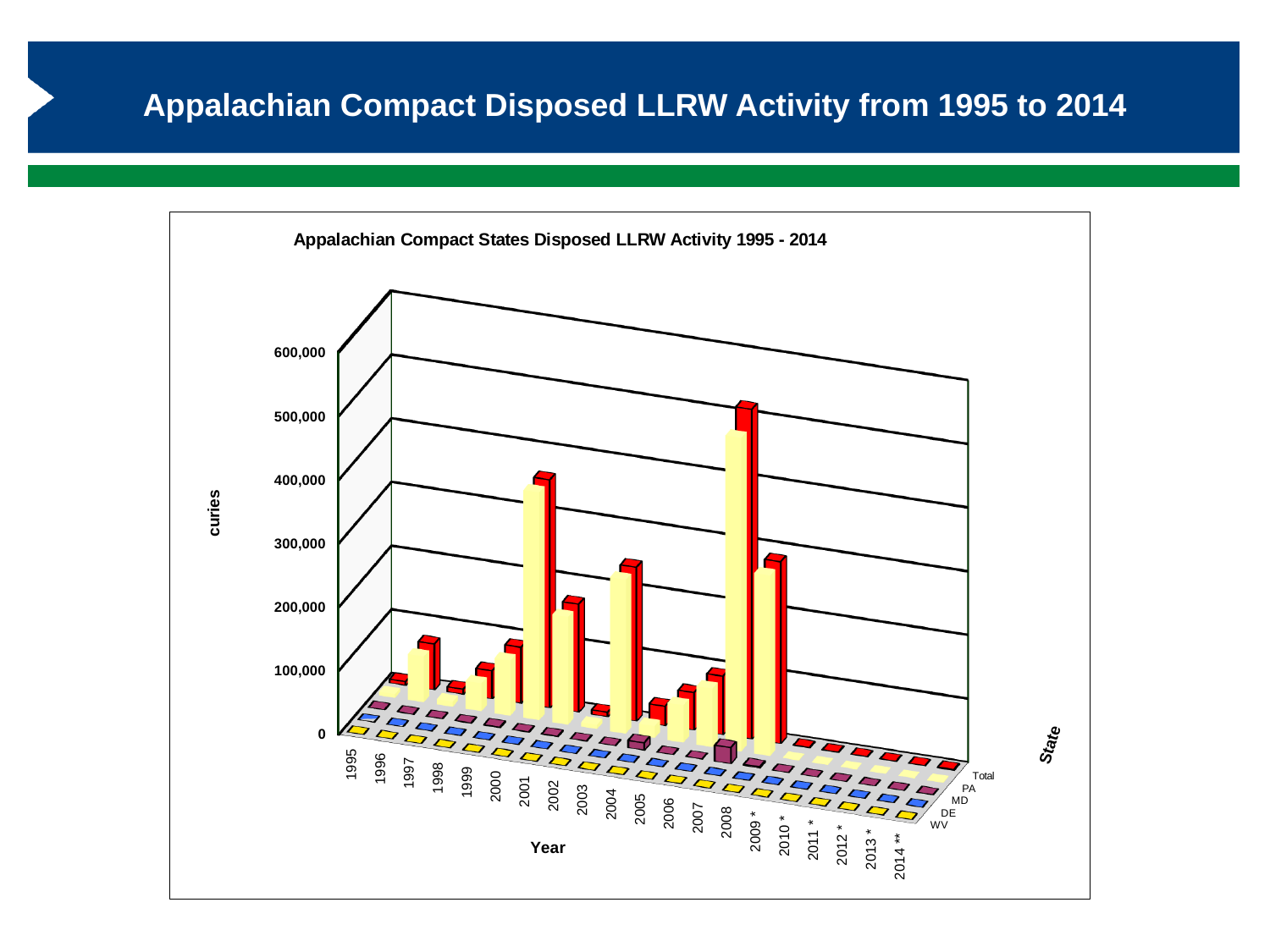
How many years are shown along the Year axis of the chart? 20 How many state series are shown on the State axis of the chart? 5 Which year has the highest Total disposed LLRW activity? 2007 Is the Total value for 1995 greater or less than 100,000 curies? less What is the title of the chart? Appalachian Compact States Disposed LLRW Activity 1995 - 2014 Is the Total value for 2008 greater or less than 400,000 curies? less What kind of chart is shown on the slide? bar chart Which year has the larger Total value, 2001 or 2004? 2001 Is the Total value for 2003 greater or less than 100,000 curies? greater Which year has the larger Total value, 2008 or 2001? 2008 What is the label on the vertical axis of the chart? curies